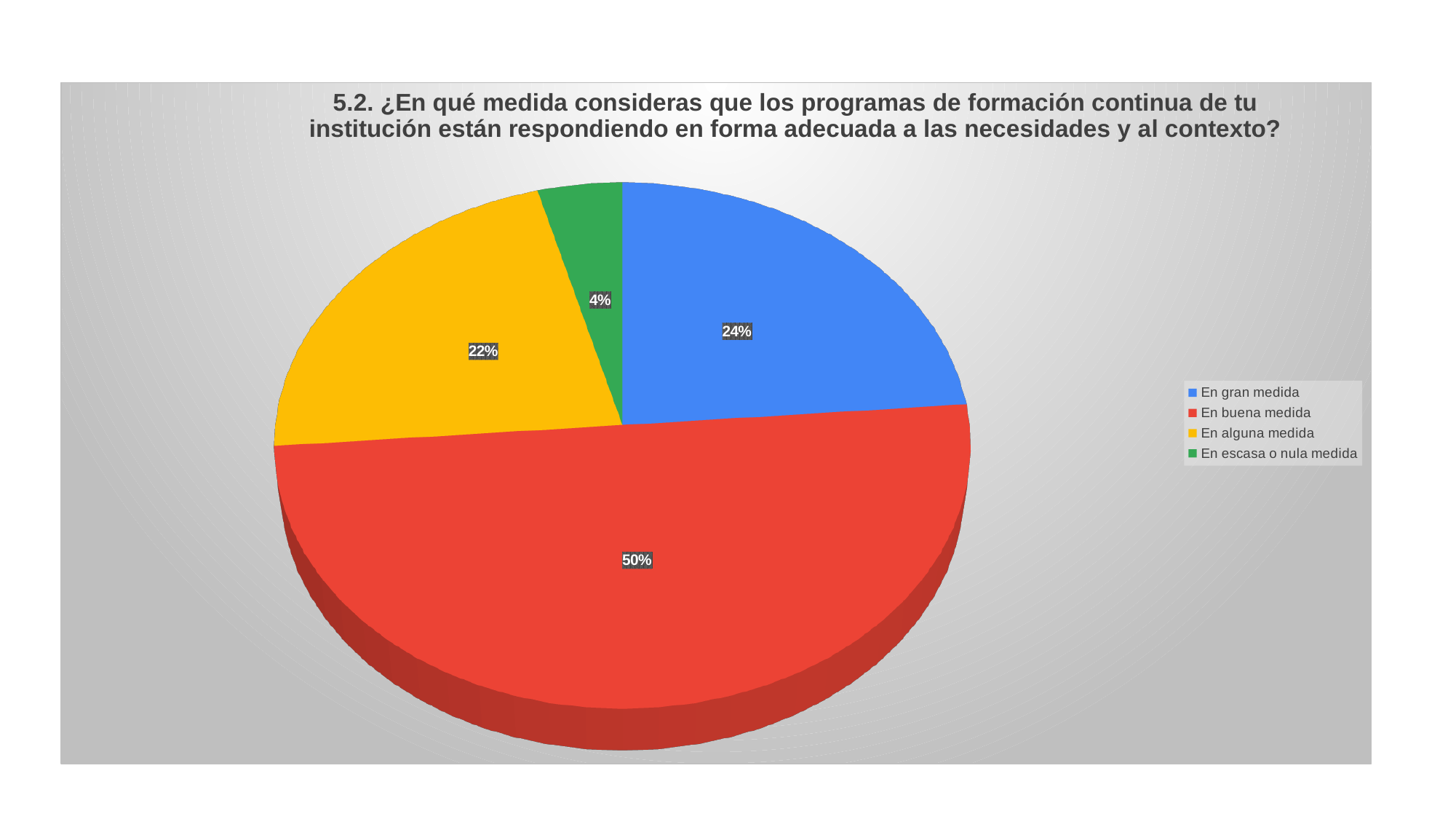
What colour is the slice for "En alguna medida"? yellow What is the difference in percentage points between "En buena medida" and "En gran medida"? 26 Which is larger, the slice for "En gran medida" or the slice for "En alguna medida"? En gran medida How many categories does the pie chart have? 4 Which category has the smallest slice of the pie? En escasa o nula medida Which category has the largest slice of the pie? En buena medida What kind of chart is shown on the slide? pie chart What share of the pie does "En escasa o nula medida" represent? 4% What share of the pie does "En buena medida" represent? 50% What share of the pie does "En alguna medida" represent? 22% What is the difference in percentage points between "En alguna medida" and "En escasa o nula medida"? 18